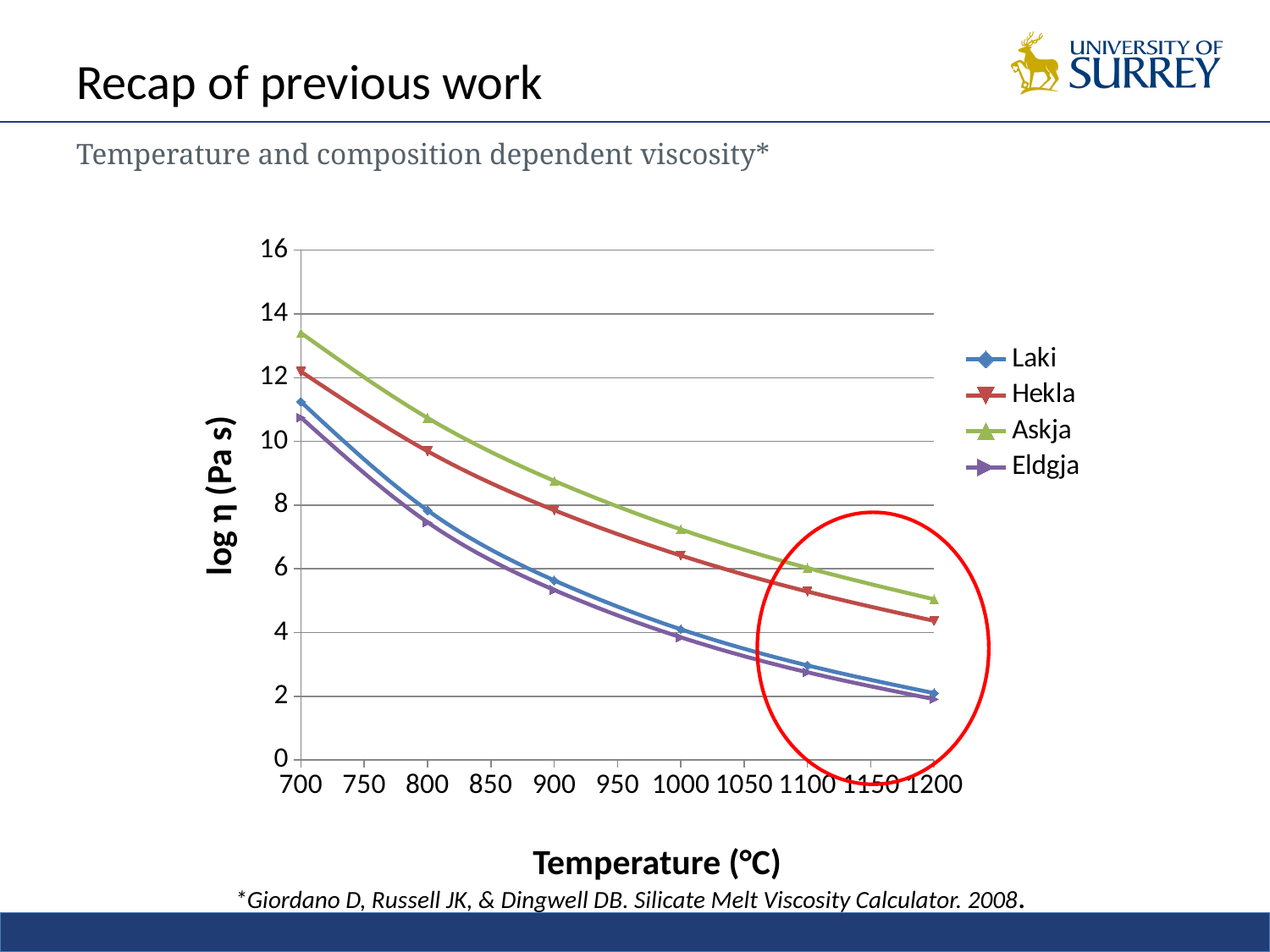
Is the value for Laki at 1100 °C greater or less than 4? less What is the title of the x axis? Temperature (°C) Which series has the highest log η value at 700 °C? Askja What kind of chart is shown on the slide? line chart How many data points are plotted for the Hekla series? 6 At 1000 °C, which series has the larger value, Askja or Laki? Askja Is the value for Eldgja at 800 °C greater or less than 8? less Which series has the lowest log η value at 700 °C? Eldgja Do the log η values rise or fall as temperature increases along the x axis? fall Is the value for Hekla at 1000 °C greater or less than 6? greater How many series does the chart legend list? 4